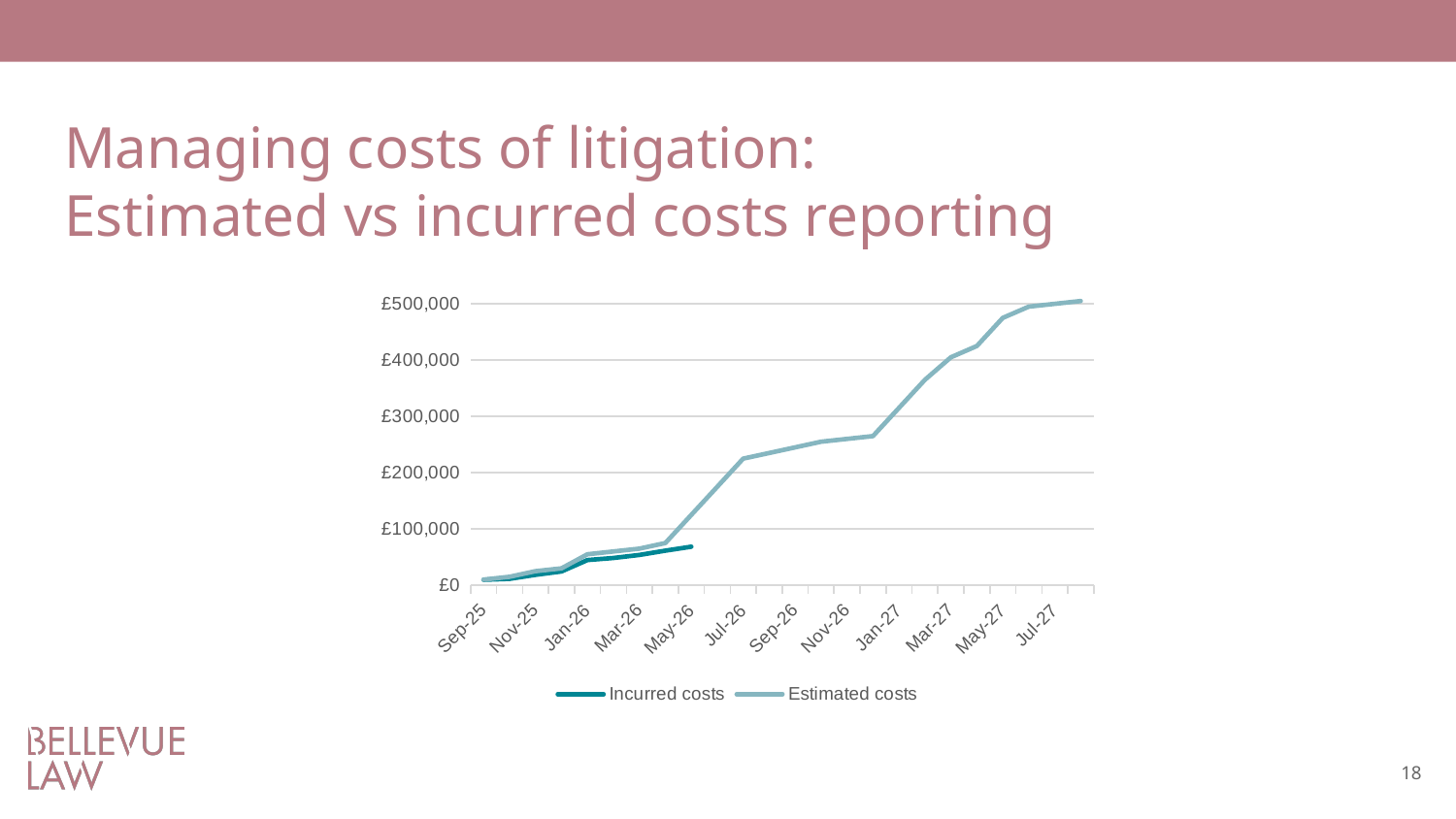
What kind of chart is shown on the slide? Line chart How many month labels are shown on the x axis? 12 Is the value for Incurred costs at May-26 greater or less than £100,000? less Do the Estimated costs rise or fall from Sep-25 to Jul-27? Rise Which series reaches the highest value on the chart? Estimated costs What are the two series named in the legend? Incurred costs and Estimated costs Is the value for Estimated costs at Mar-27 greater or less than £300,000? greater Which series extends further along the x axis, Incurred costs or Estimated costs? Estimated costs Is the value for Estimated costs at Jul-27 greater or less than £400,000? greater How many series does the legend list? 2